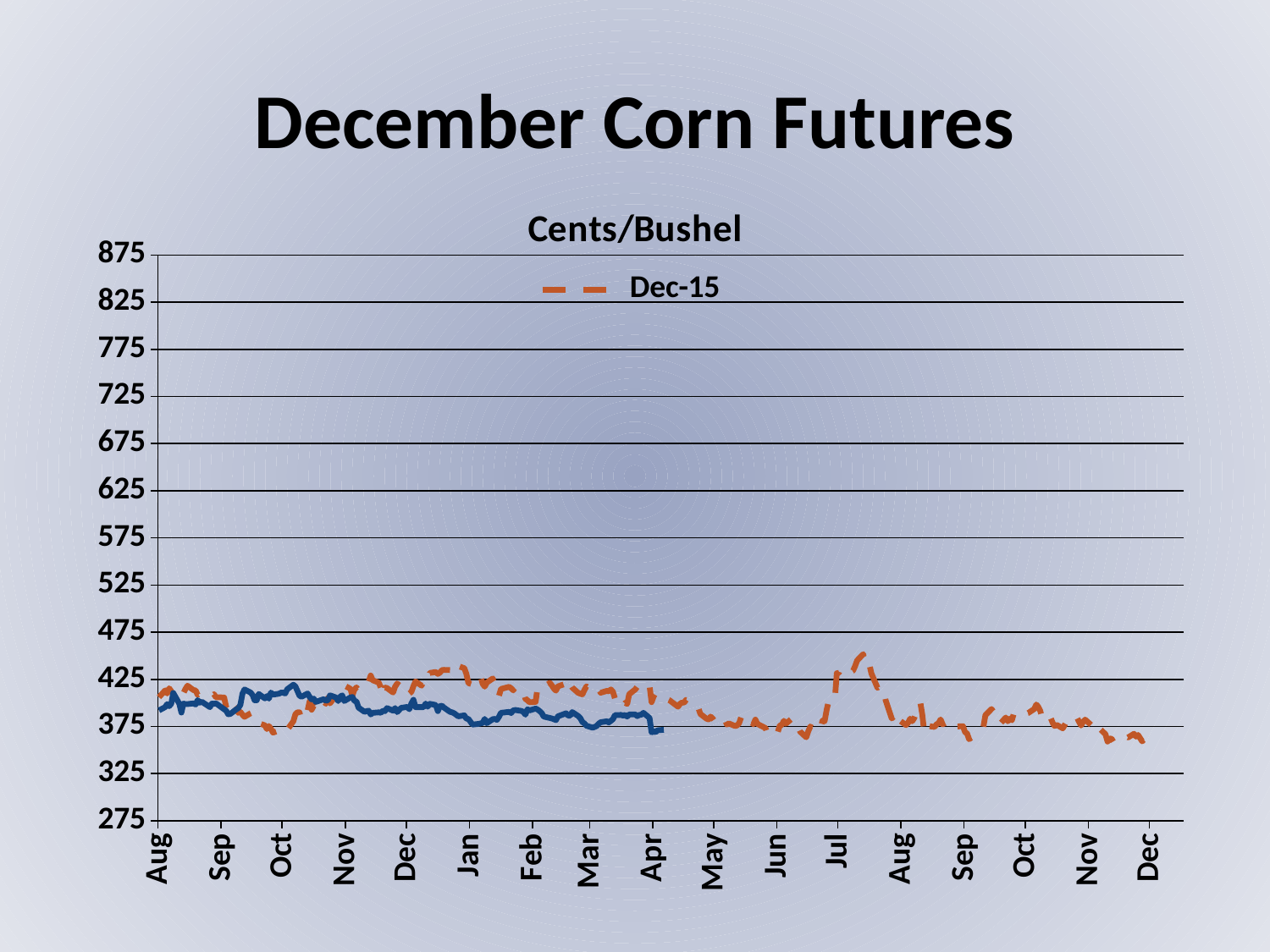
Is the value of the Dec-15 series at the end of the chart (Dec) greater or less than 375? less Is the highest value of the Dec-15 series, reached around Jul, greater or less than 425? greater Around which month does the Dec-15 series reach its highest point? Jul What kind of chart is shown on the slide? Line chart What is the highest value shown on the y axis? 875 What is the name of the series listed in the legend? Dec-15 What is the title shown above the chart's plot area? Cents/Bushel Is the value of the Dec-15 series around Jan greater or less than 400? greater Does the Dec-15 series rise or fall from its peak around Jul to the end of the chart in Dec? Fall How many month labels are shown along the x axis? 17 How many series does the chart's legend list? 1